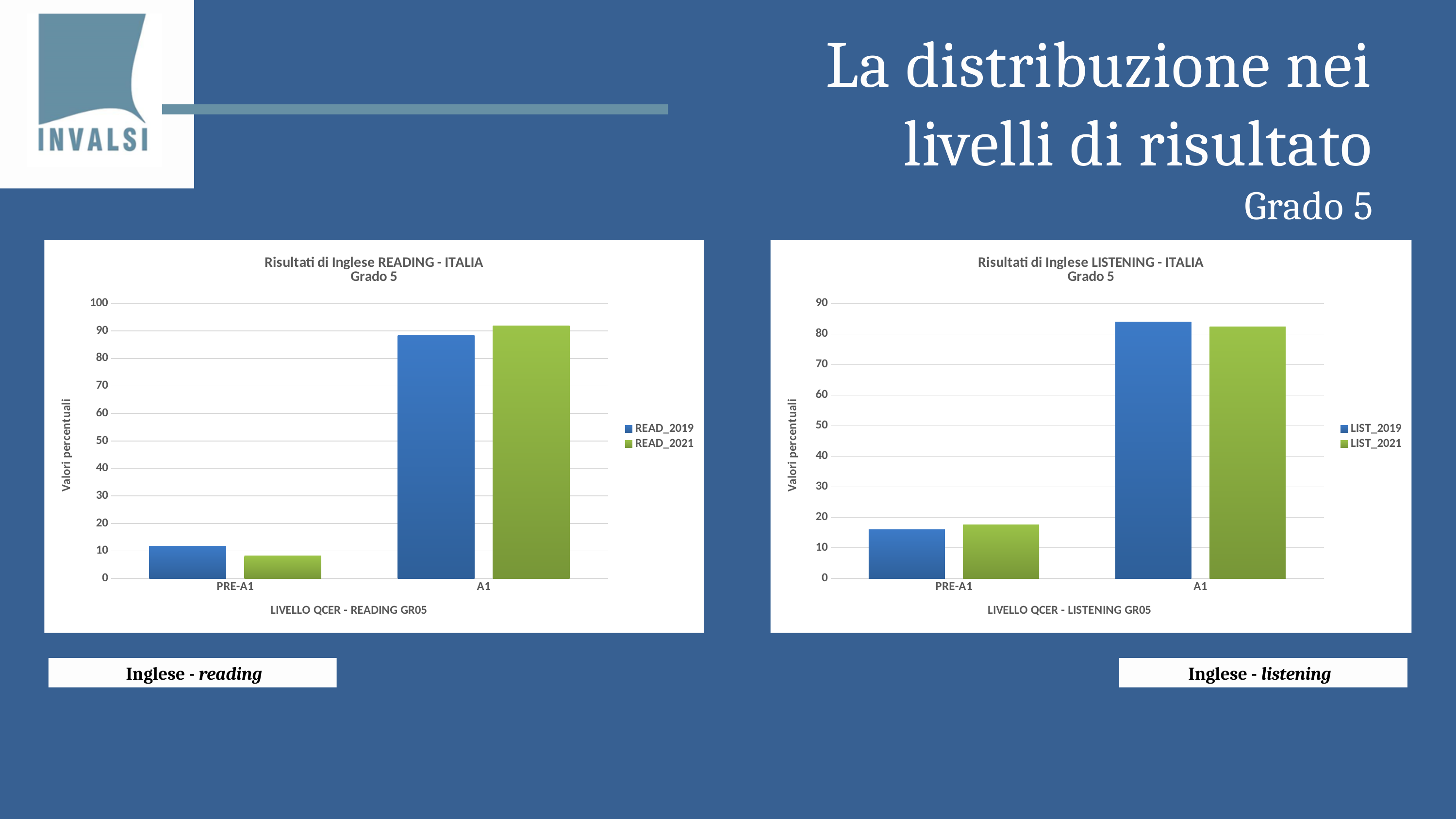
What kind of chart is the 'Risultati di Inglese READING - ITALIA Grado 5' chart? bar chart In the 'Risultati di Inglese LISTENING - ITALIA Grado 5' chart, is the LIST_2021 value for A1 greater or less than 70? greater In the 'Risultati di Inglese READING - ITALIA Grado 5' chart, is the READ_2019 value for A1 greater or less than 80? greater What is the y-axis label of the 'Risultati di Inglese LISTENING - ITALIA Grado 5' chart? Valori percentuali In the 'Risultati di Inglese LISTENING - ITALIA Grado 5' chart, is the LIST_2019 value for PRE-A1 greater or less than 20? less How many series does the legend of the 'Risultati di Inglese LISTENING - ITALIA Grado 5' chart list? 2 In the 'Risultati di Inglese READING - ITALIA Grado 5' chart, which category has the highest value for READ_2021? A1 How many categories are shown on the x axis of the 'Risultati di Inglese READING - ITALIA Grado 5' chart? 2 In the 'Risultati di Inglese READING - ITALIA Grado 5' chart, for PRE-A1, which series has the larger value, READ_2019 or READ_2021? READ_2019 In the 'Risultati di Inglese LISTENING - ITALIA Grado 5' chart, which category has the lowest value for LIST_2019? PRE-A1 In the 'Risultati di Inglese READING - ITALIA Grado 5' chart, for A1, which series has the larger value, READ_2019 or READ_2021? READ_2021